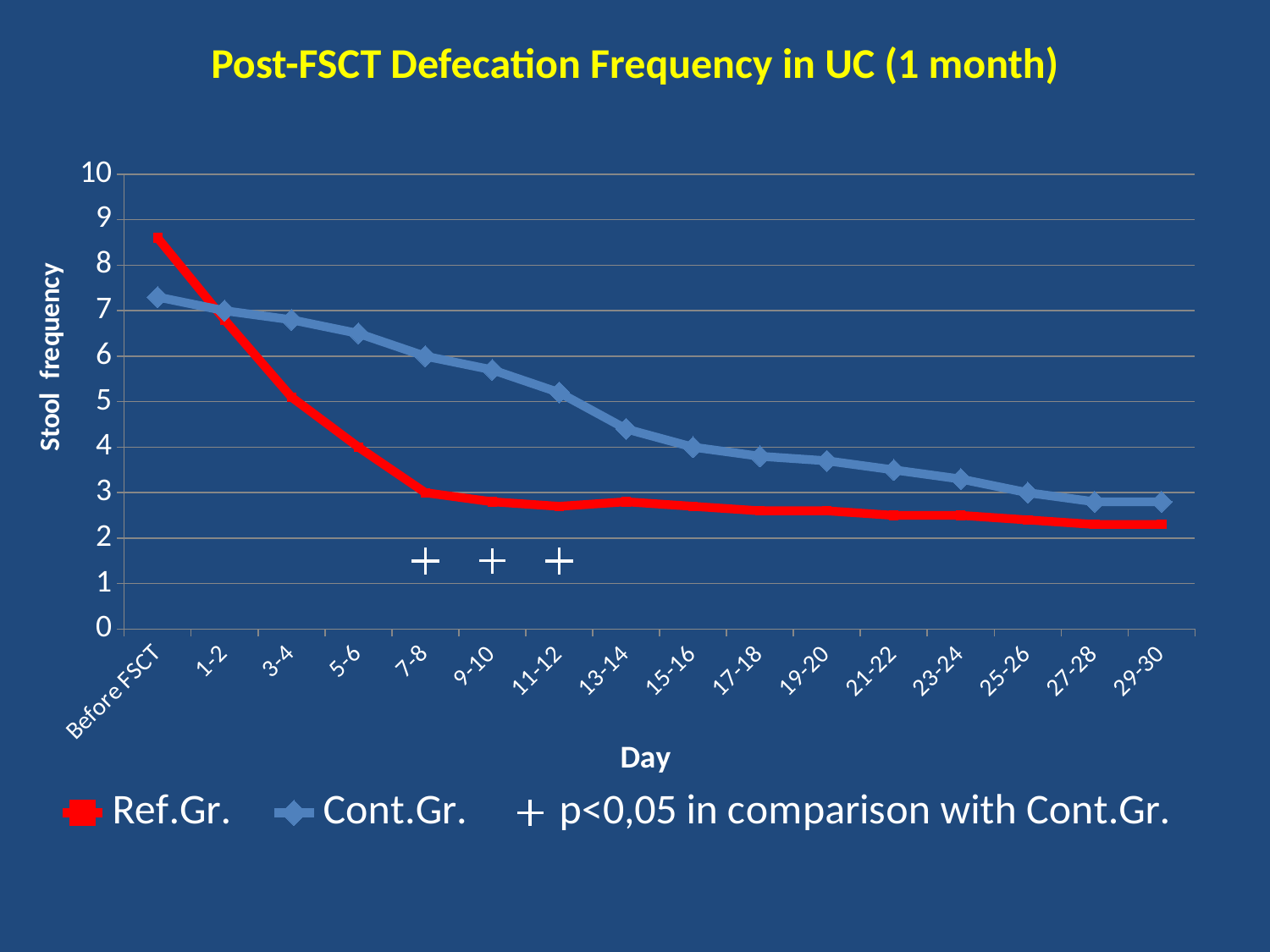
Is the value for Ref.Gr. at day 29-30 greater or less than 3? less Is the value for Cont.Gr. at day 5-6 greater or less than 6? greater How many categories are shown on the x axis (Day)? 16 Is the value for Cont.Gr. at Before FSCT greater or less than 7? greater What kind of chart is shown on the slide? line chart Do the Ref.Gr. values rise or fall from Before FSCT to day 29-30? fall At day 7-8, which series has the higher stool frequency, Ref.Gr. or Cont.Gr.? Cont.Gr. How many entries does the legend list? 3 At Before FSCT, which series has the higher stool frequency, Ref.Gr. or Cont.Gr.? Ref.Gr. At which x-axis category is the Ref.Gr. value highest? Before FSCT